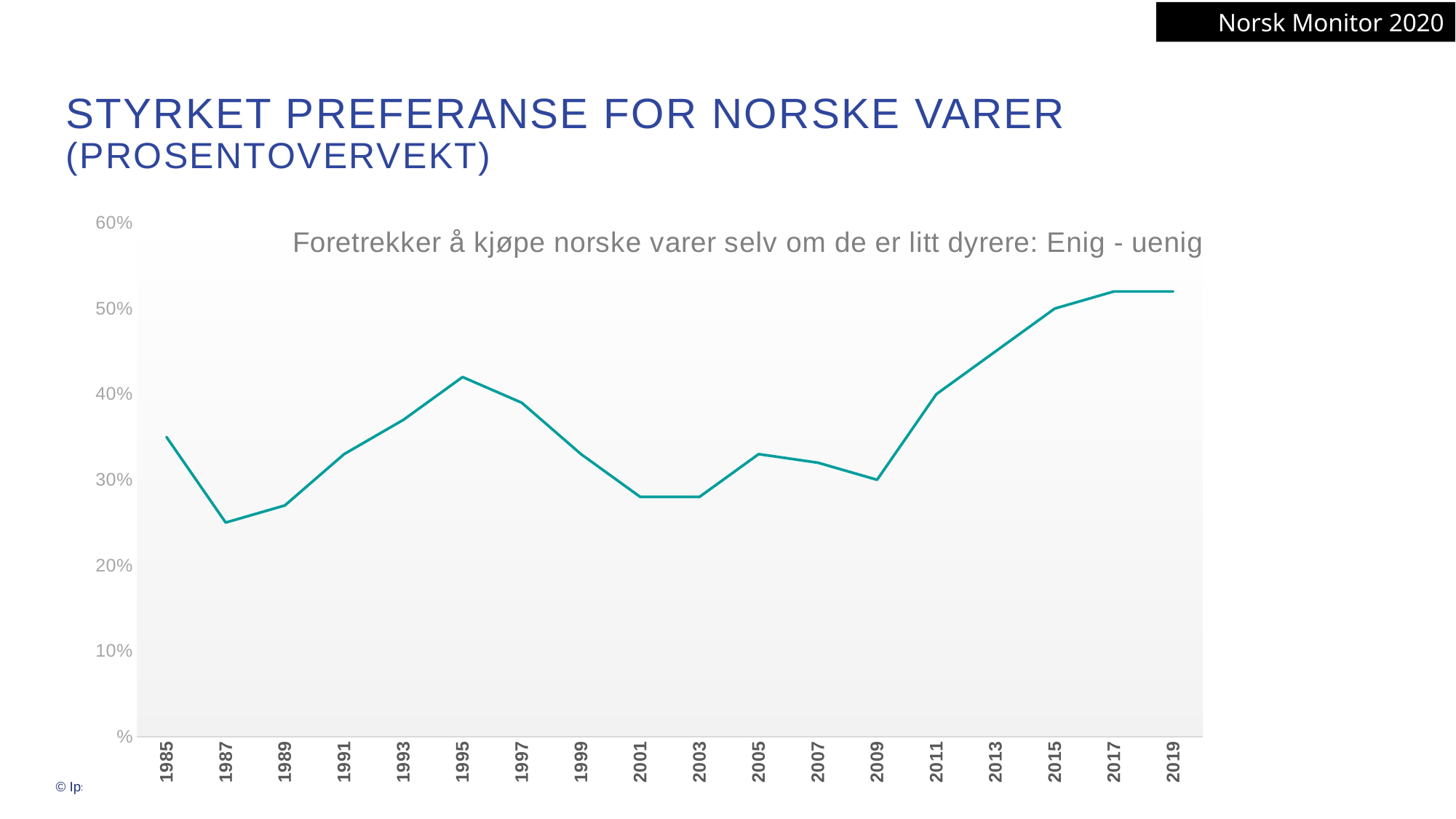
What is the text shown inside the chart area describing the plotted series? Foretrekker å kjøpe norske varer selv om de er litt dyrere: Enig - uenig What kind of chart is shown on the slide? line chart Which year has the lowest value on the chart? 1987 Is the value for 1987 greater or less than 30%? less Do the values rise or fall from 2009 to 2019? rise How many years are plotted along the x axis of the chart? 18 Is the value for 2019 greater or less than 50%? greater Is the value for 2001 greater or less than 30%? less Which year has the larger value, 1995 or 2005? 1995 Which year has the larger value, 2013 or 1993? 2013